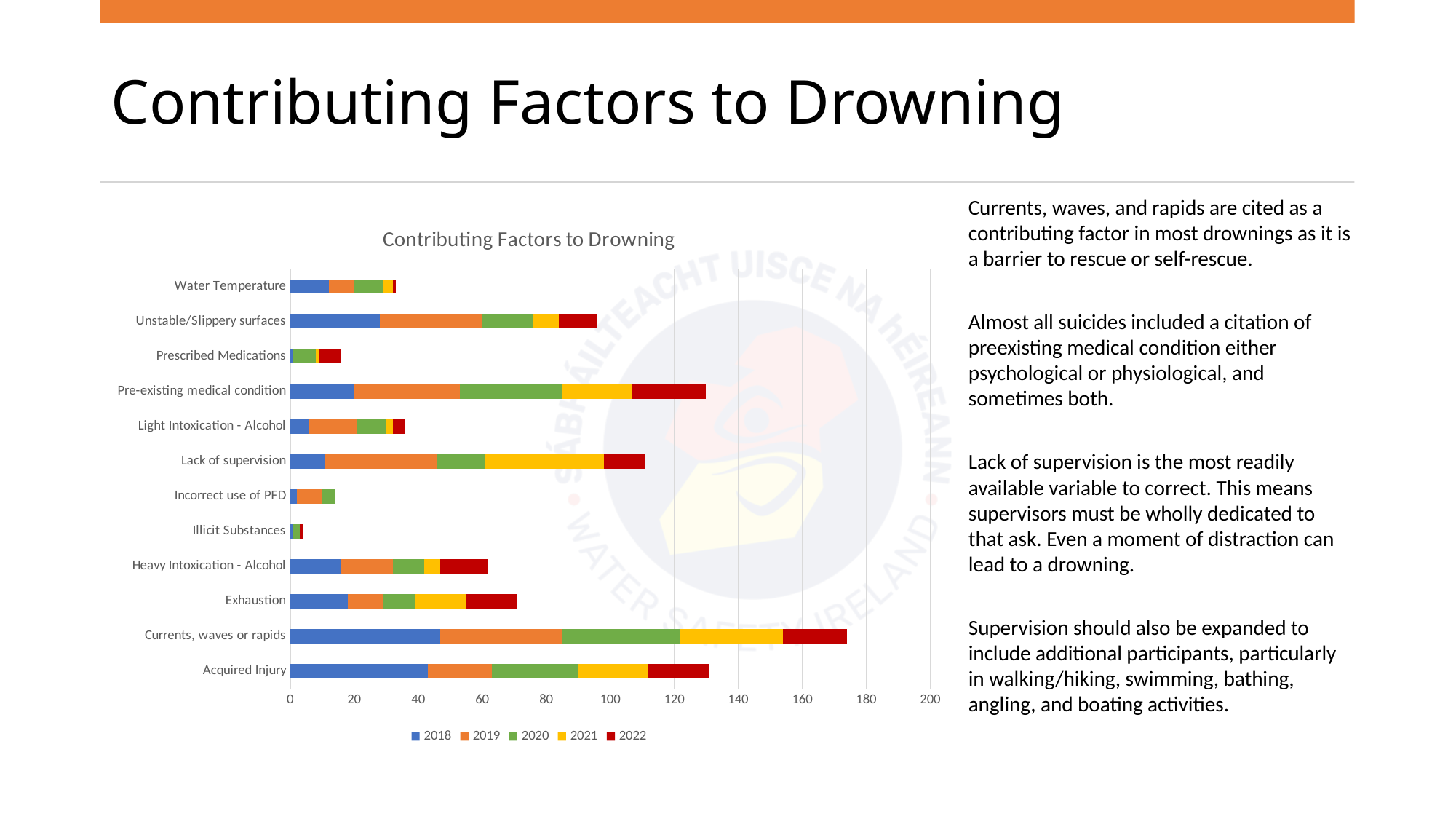
How many series does the chart legend list? 5 Which contributing factor has the longest total bar? Currents, waves or rapids Which has the longer total bar: Lack of supervision or Unstable/Slippery surfaces? Lack of supervision Which year does the red series in the legend represent? 2022 Is the total bar for Unstable/Slippery surfaces greater or less than 100? less What kind of chart is shown on the slide? Stacked bar chart How many contributing factor categories are plotted on the chart? 12 Which contributing factor has the shortest total bar? Illicit Substances Is the total bar for Lack of supervision greater or less than 100? greater What is the title of the chart? Contributing Factors to Drowning Is the total bar for Water Temperature greater or less than 40? less